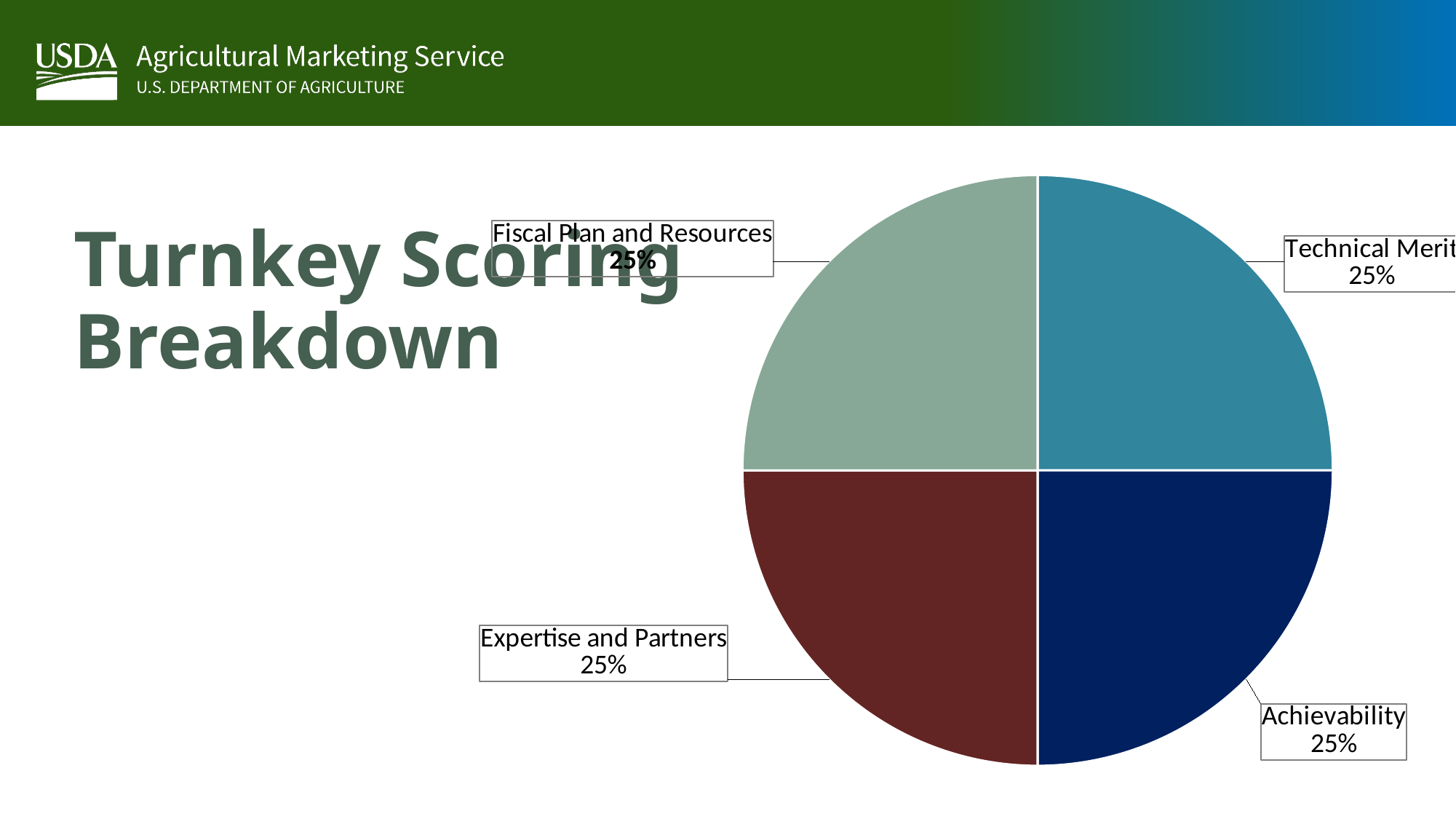
What share of the pie does Technical Merit represent? 25% What is the combined share of Technical Merit and Achievability? 50% What share of the pie does Achievability represent? 25% What is the value labelled for the Fiscal Plan and Resources slice? 25% What kind of chart is shown on the slide? pie chart What is the difference between the shares of Technical Merit and Expertise and Partners? 0% What is the title of the slide containing the pie chart? Turnkey Scoring Breakdown What share of the pie does Fiscal Plan and Resources represent? 25% Which slice of the pie chart is coloured dark red? Expertise and Partners What is the value labelled for the Achievability slice? 25% How many slices does the pie chart have? 4